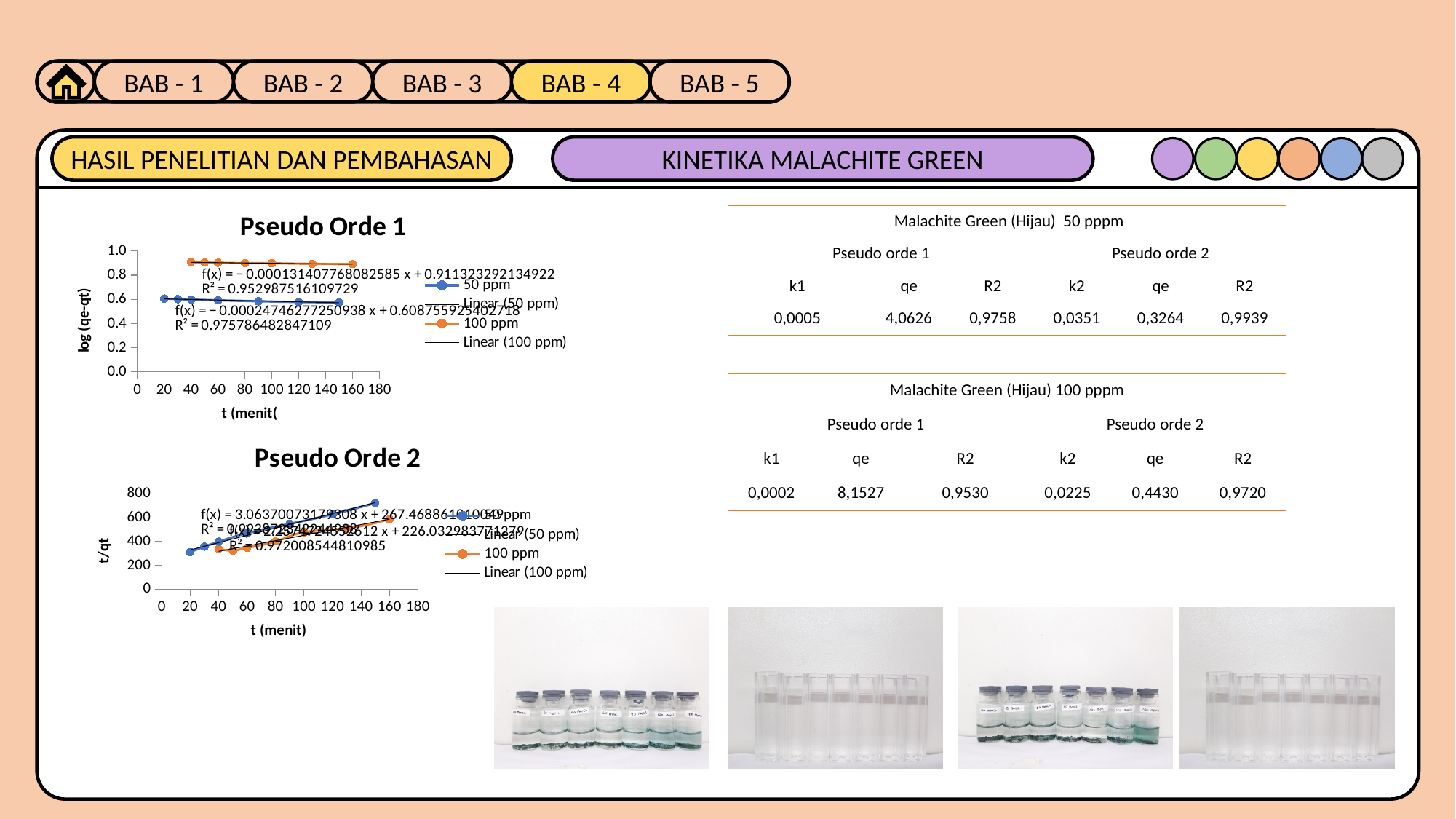
On the Pseudo Orde 1 chart, are the values for 100 ppm greater or less than 0.8? greater On the Pseudo Orde 2 chart, is the t/qt value for 50 ppm at t = 150 menit greater or less than 600? greater On the Pseudo Orde 2 chart, how many series does the legend list? 4 On the Pseudo Orde 1 chart, how many series does the legend list? 4 What kind of chart is the Pseudo Orde 2 chart? line chart On the Pseudo Orde 2 chart, do the t/qt values for 50 ppm rise or fall as t increases? rise On the Pseudo Orde 1 chart, are the values for 50 ppm greater or less than 0.8? less What is the y-axis title of the Pseudo Orde 2 chart? t/qt On the Pseudo Orde 1 chart, which series has the higher log(qe-qt) values, 50 ppm or 100 ppm? 100 ppm On the Pseudo Orde 2 chart, at t = 150 menit, which series has the larger t/qt value, 50 ppm or 100 ppm? 50 ppm On the Pseudo Orde 1 chart, do the values for 100 ppm rise or fall as t increases? fall